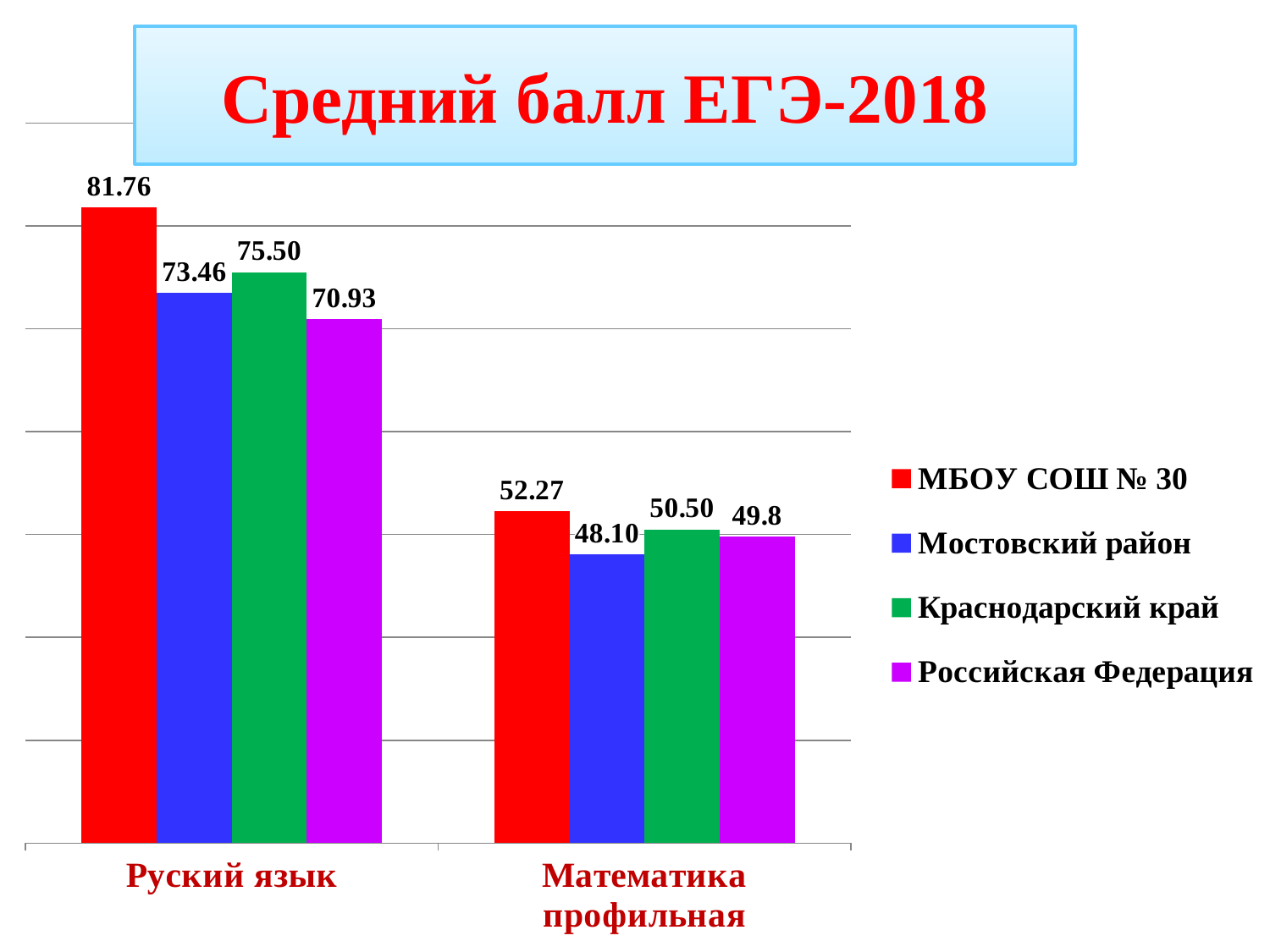
What kind of chart is shown on the slide? Bar chart What is the difference between the МБОУ СОШ № 30 and Мостовский район values in the Руский язык category? 8.30 What is the value for МБОУ СОШ № 30 in the Руский язык category? 81.76 Which series has the highest value in the Руский язык category? МБОУ СОШ № 30 Which is larger in the Математика профильная category: Краснодарский край or Российская Федерация? Краснодарский край How many categories are shown on the x axis? 2 What is the title of the chart? Средний балл ЕГЭ-2018 What is the value for Российская Федерация in the Математика профильная category? 49.8 What is the value for Краснодарский край in the Руский язык category? 75.50 Which series has the lowest value in the Математика профильная category? Мостовский район How many series does the legend list? 4 What is the value for Мостовский район in the Математика профильная category? 48.10